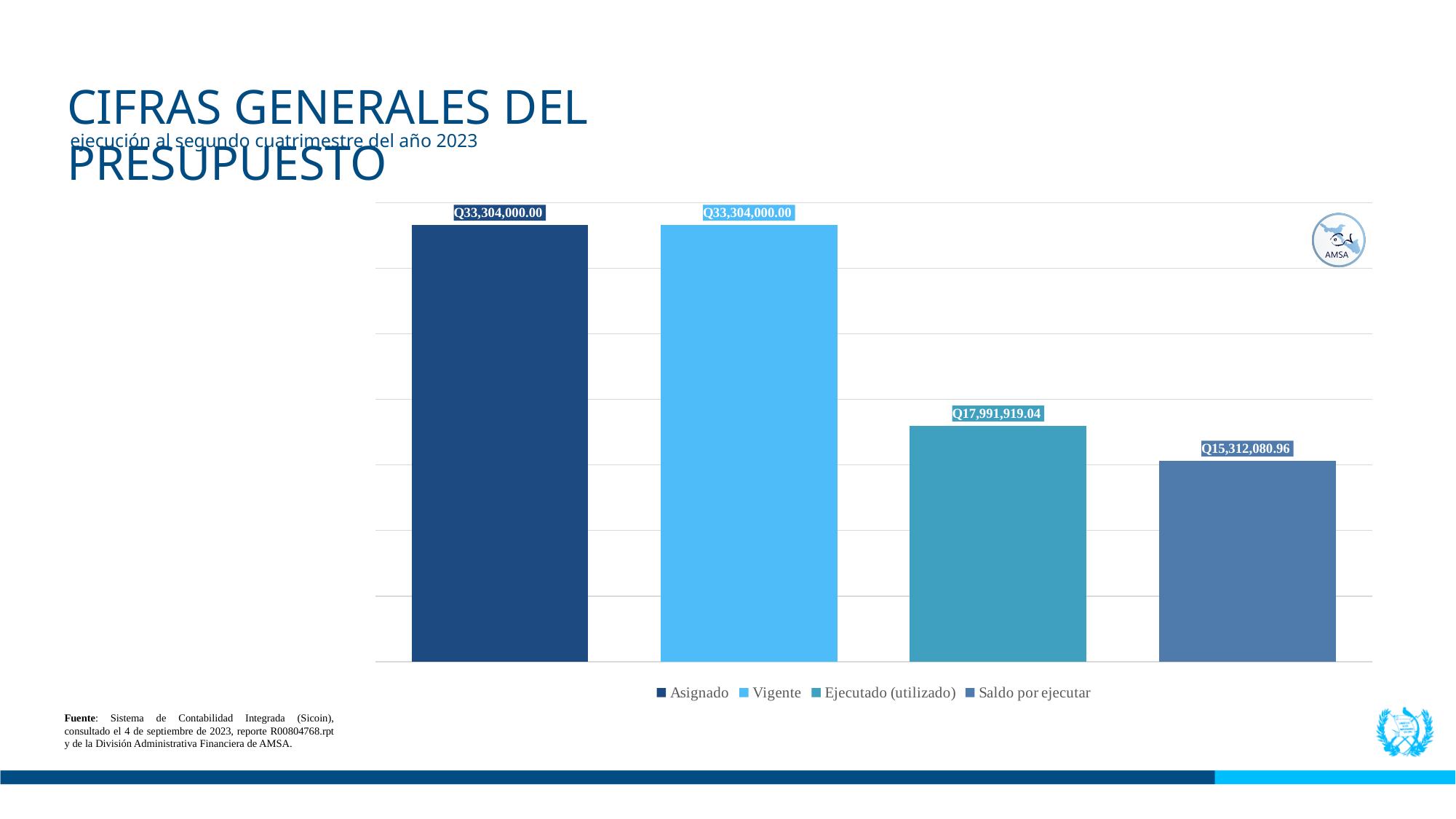
What is the value of the Saldo por ejecutar bar? Q15,312,080.96 How many bars are plotted in the chart? 4 Which is larger, Ejecutado (utilizado) or Saldo por ejecutar? Ejecutado (utilizado) How many series does the legend list? 4 What is the value of the Ejecutado (utilizado) bar? Q17,991,919.04 What colour is the Vigente bar in the chart? Light blue Which series has the lowest value in the chart? Saldo por ejecutar What is the value of the Asignado bar? Q33,304,000.00 What kind of chart is shown on the slide? Bar chart What is the difference between the Asignado value and the Ejecutado (utilizado) value? Q15,312,080.96 What is the value of the Vigente bar? Q33,304,000.00 What is the difference between the Ejecutado (utilizado) value and the Saldo por ejecutar value? Q2,679,838.08